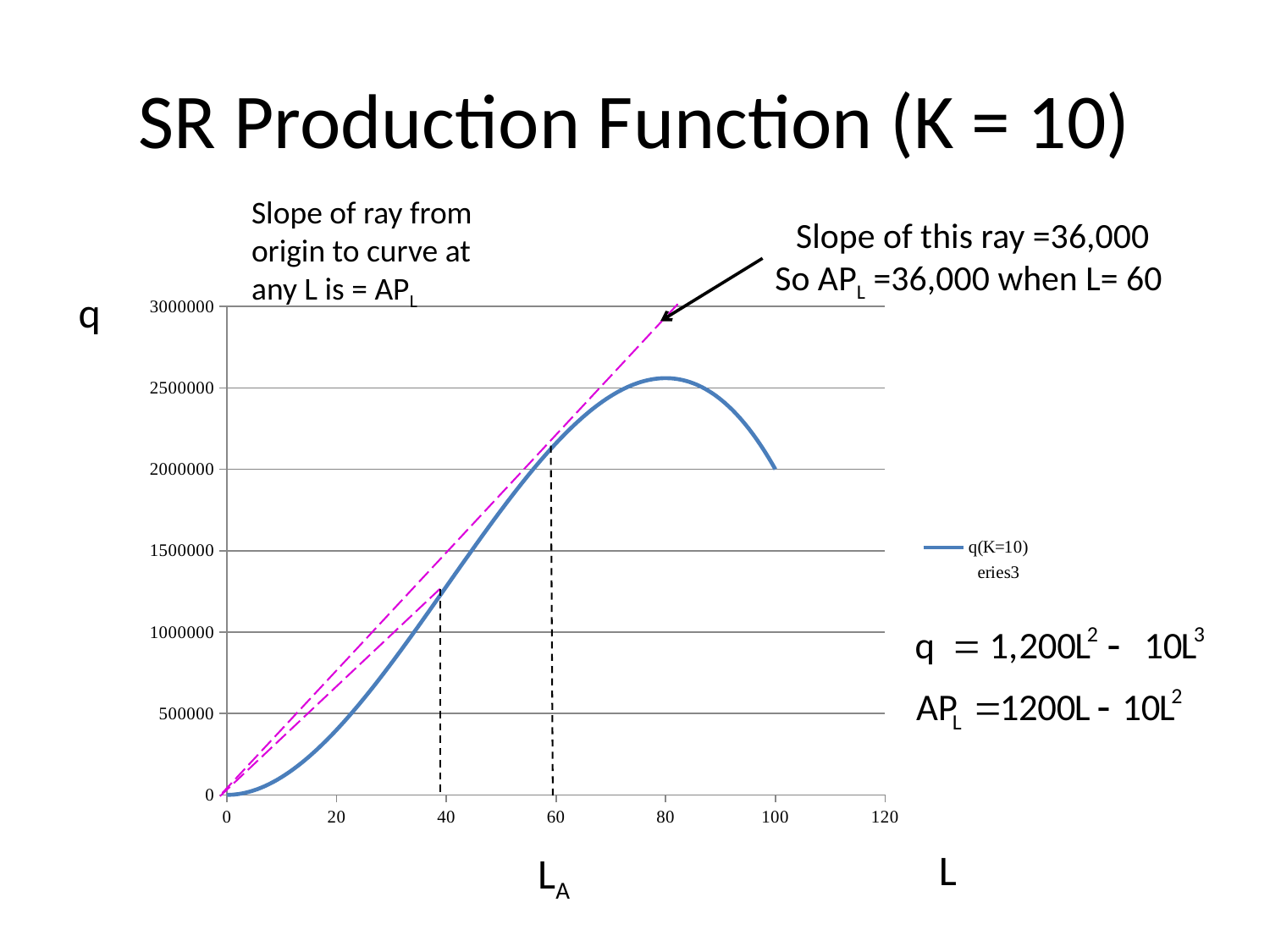
Is the value of q(K=10) at L = 60 greater or less than 2000000? greater What is the title of the slide's chart? SR Production Function (K = 10) Is the value of q(K=10) at L = 20 greater or less than 500000? less Which is larger, the value of q(K=10) at L = 60 or at L = 40? L = 60 What is the name of the first series in the legend? q(K=10) How many series does the chart's legend list? 2 What kind of chart is shown on the slide? line chart Is the value of q(K=10) at L = 80 greater or less than 3000000? less Does the q(K=10) curve rise or fall between L = 80 and L = 100? fall What is the value of q(K=10) at L = 100? 2000000